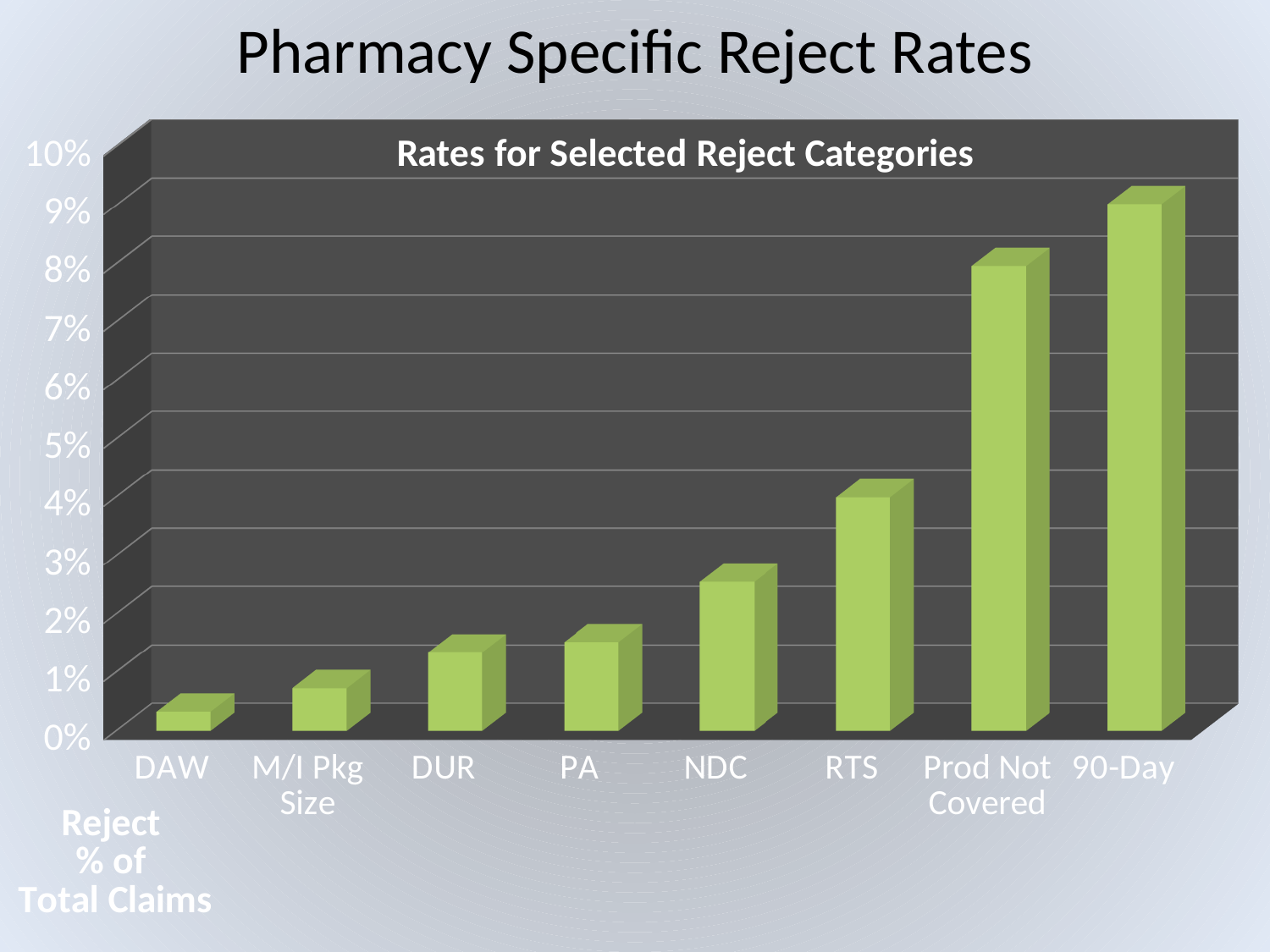
Which has a higher reject rate, Prod Not Covered or 90-Day? 90-Day What is the title shown inside the chart area? Rates for Selected Reject Categories Is the value for RTS greater or less than 5%? less Which reject category has the lowest reject rate? DAW Is the value for Prod Not Covered greater or less than 7%? greater What kind of chart is shown on the slide? bar chart How many reject categories are plotted on the chart? 8 Which has a higher reject rate, RTS or NDC? RTS Which reject category has the highest reject rate? 90-Day Is the value for DAW greater or less than 1%? less Do the reject rates rise or fall moving from left to right along the x axis? rise